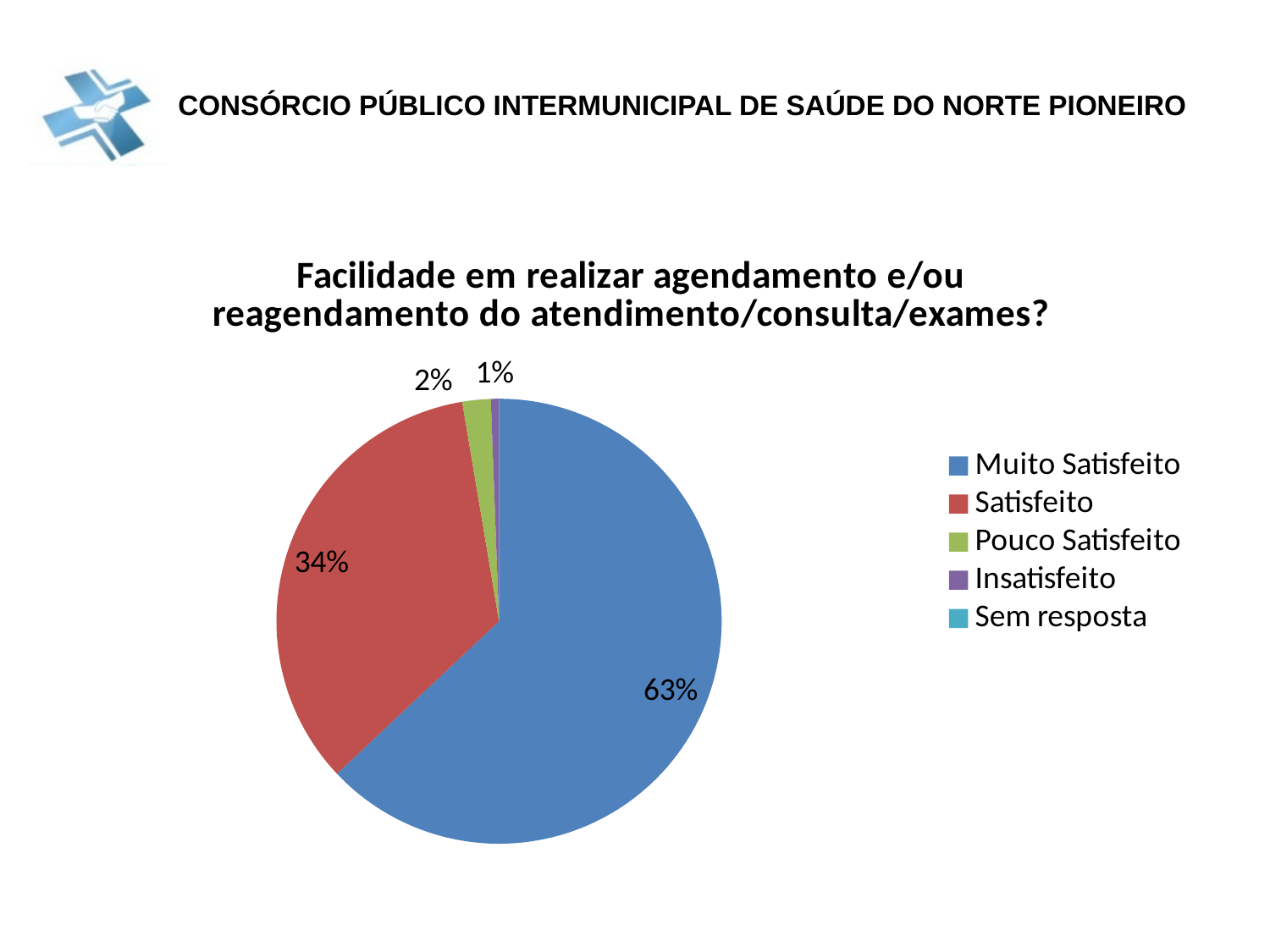
How many entries does the legend list? 5 What kind of chart is shown on the slide? Pie chart Which is larger, the share for "Satisfeito" or the share for "Pouco Satisfeito"? Satisfeito Which category has the largest share of the pie? Muito Satisfeito What percentage of respondents answered "Pouco Satisfeito"? 2% Which labelled category has the smallest share of the pie? Insatisfeito What colour is the "Satisfeito" slice? Red What percentage of respondents answered "Insatisfeito"? 1% What percentage of respondents answered "Satisfeito"? 34% What is the difference in percentage points between "Muito Satisfeito" and "Satisfeito"? 29 What percentage of respondents answered "Muito Satisfeito"? 63% What is the combined share of "Muito Satisfeito" and "Satisfeito"? 97%